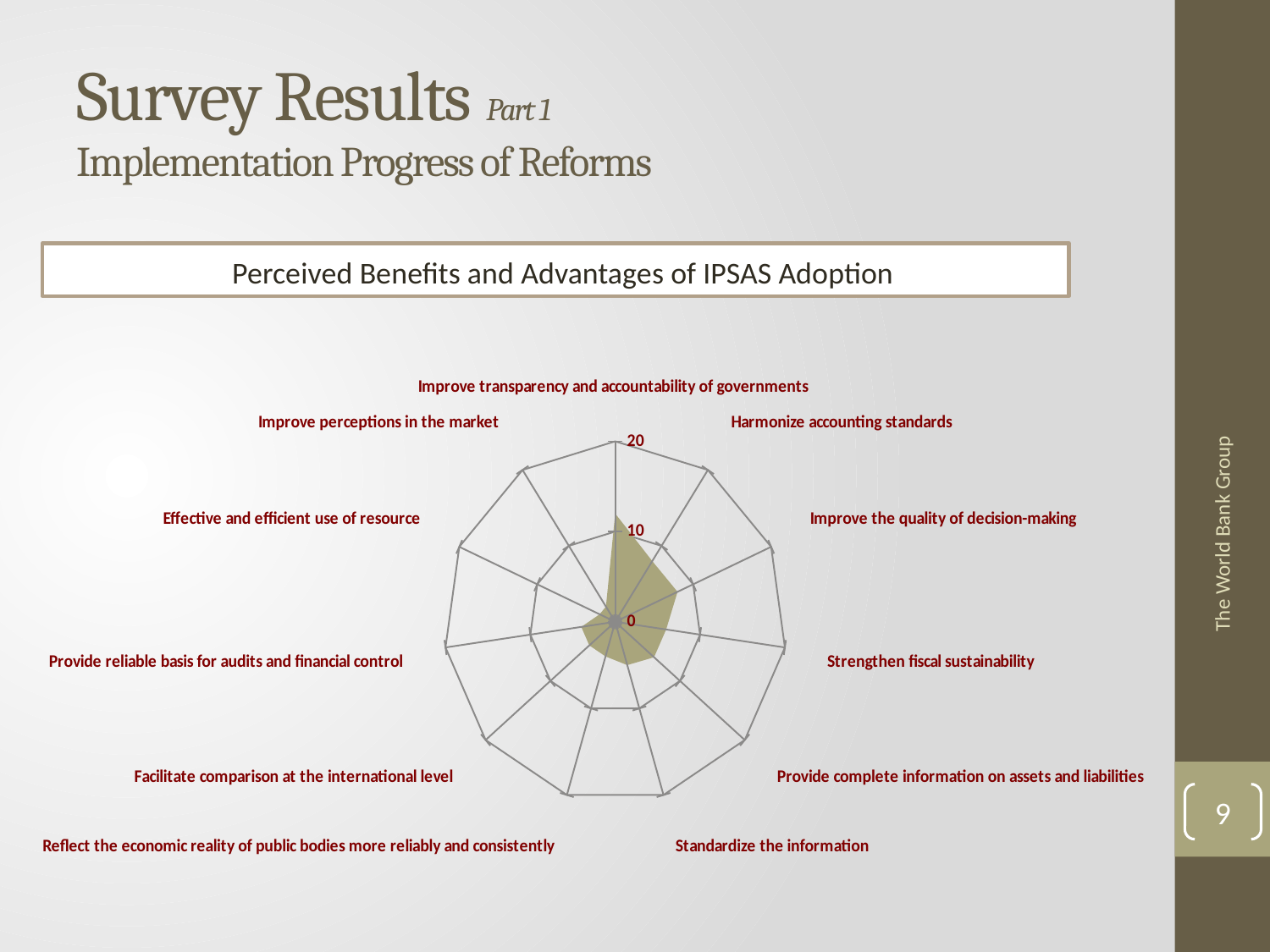
Is the value for 'Harmonize accounting standards' greater or less than 10? less Which category has the highest value on the radar chart? Improve transparency and accountability of governments What kind of chart is shown on the slide? radar chart Which is larger: the value for 'Harmonize accounting standards' or the value for 'Facilitate comparison at the international level'? Harmonize accounting standards Is the value for 'Improve transparency and accountability of governments' greater or less than 10? greater Is the value for 'Strengthen fiscal sustainability' greater or less than 10? less How many categories (benefits) are plotted on the radar chart? 11 What is the title shown above the chart? Perceived Benefits and Advantages of IPSAS Adoption What is the maximum value shown on the radar chart's axis? 20 Which is larger: the value for 'Improve transparency and accountability of governments' or the value for 'Strengthen fiscal sustainability'? Improve transparency and accountability of governments